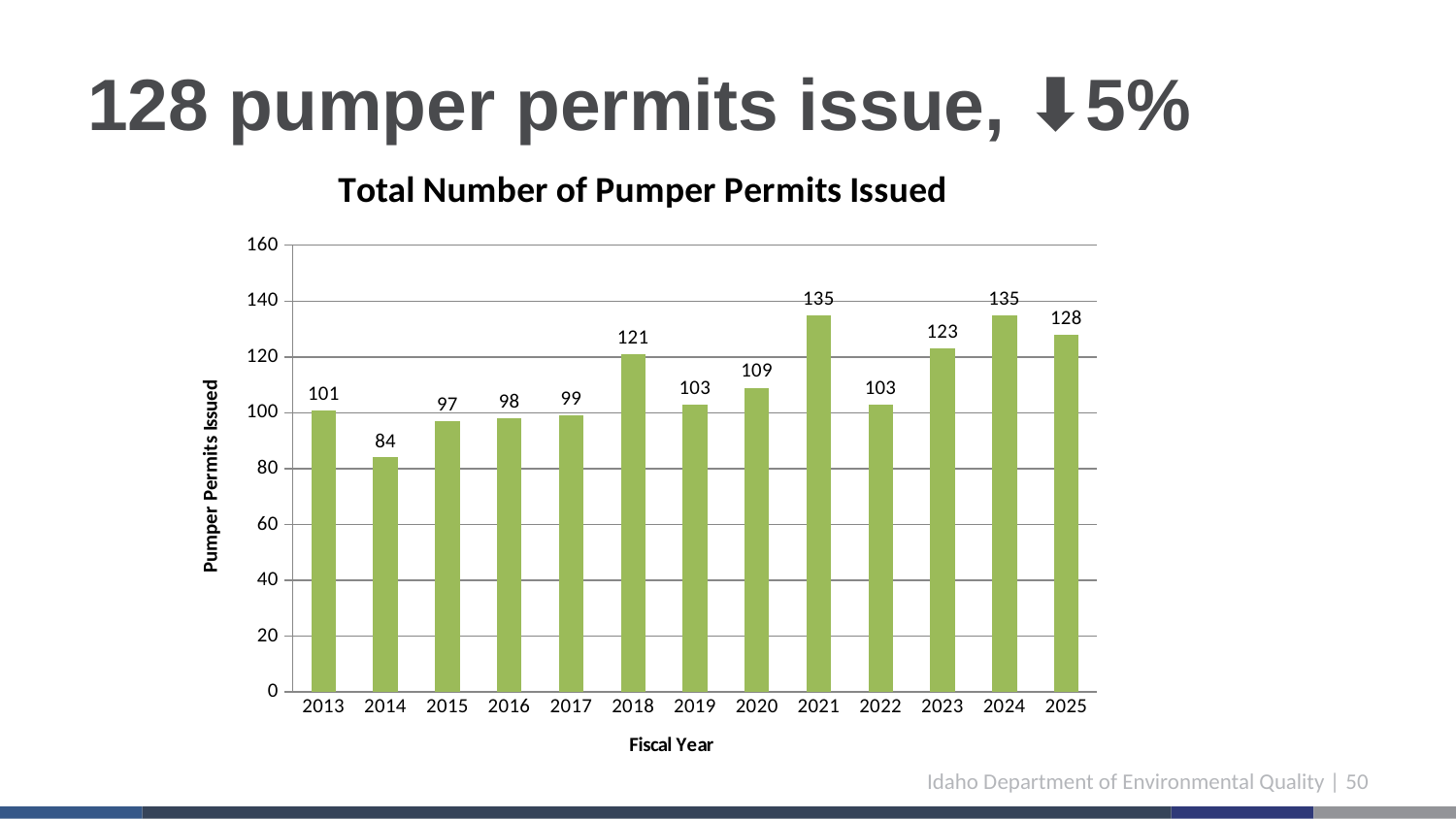
What is the number of pumper permits issued in fiscal year 2014? 84 What is the number of pumper permits issued in fiscal year 2025? 128 What kind of chart is used to show the total number of pumper permits issued? bar chart Which fiscal year has the lowest number of pumper permits issued? 2014 What is the number of pumper permits issued in fiscal year 2018? 121 How many fiscal years are shown on the x axis of the chart? 13 What is the difference in pumper permits issued between fiscal year 2024 and fiscal year 2025? 7 What is the difference in pumper permits issued between fiscal year 2021 and fiscal year 2022? 32 What is the highest number of pumper permits issued in any fiscal year shown? 135 What is the title of the chart? Total Number of Pumper Permits Issued Which fiscal year had more pumper permits issued, 2020 or 2023? 2023 Is the value for fiscal year 2019 greater or less than 120? less